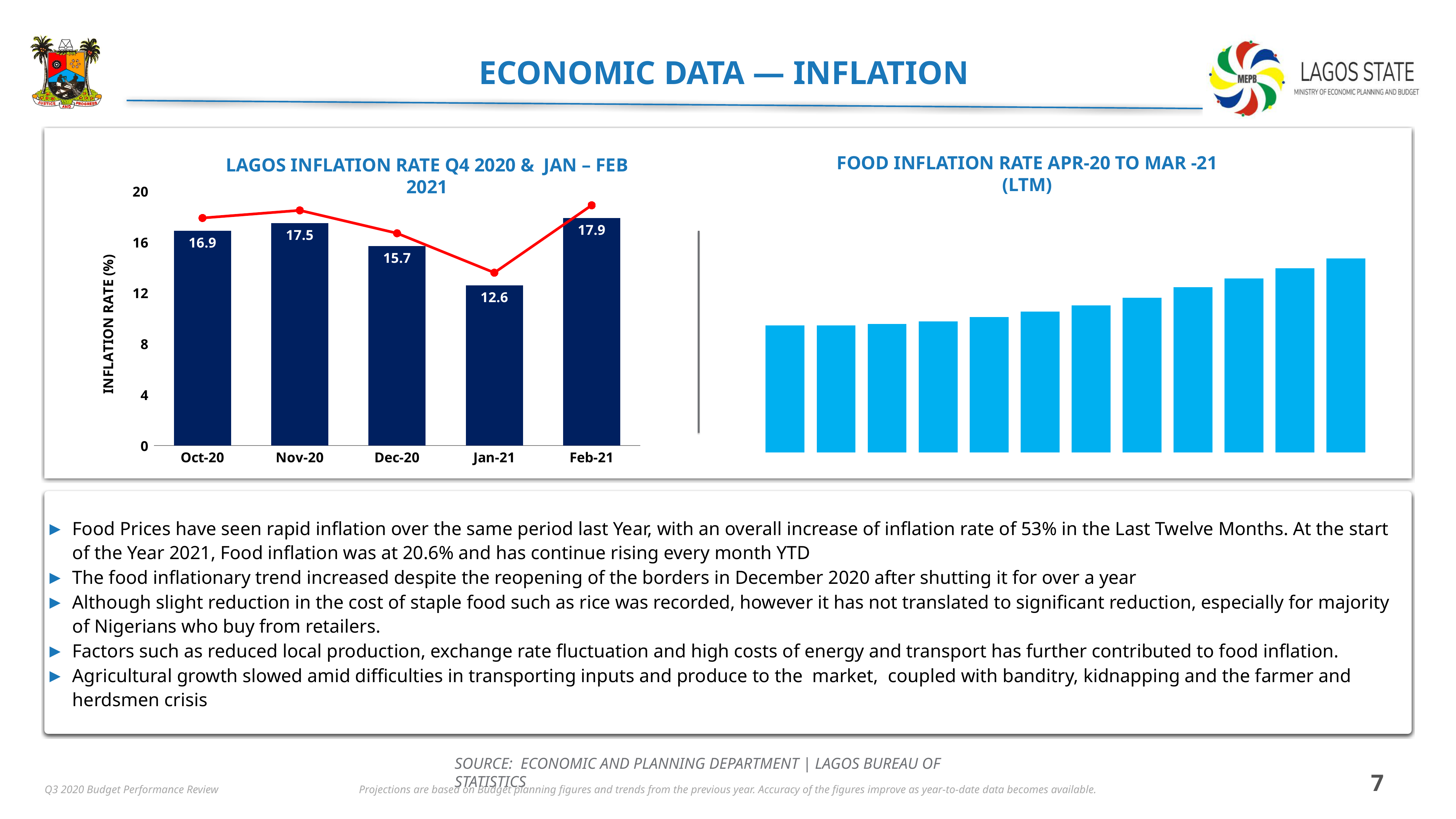
In the LAGOS INFLATION RATE chart, which month has the highest inflation rate? Feb-21 How many months are shown on the x axis of the LAGOS INFLATION RATE chart? 5 In the LAGOS INFLATION RATE chart, which is higher, the inflation rate for Nov-20 or Dec-20? Nov-20 In the LAGOS INFLATION RATE chart, what is the inflation rate for Oct-20? 16.9 In the LAGOS INFLATION RATE chart, which month has the lowest inflation rate? Jan-21 In the LAGOS INFLATION RATE chart, is the value for Jan-21 greater or less than 16? less What kind of chart is the FOOD INFLATION RATE APR-20 TO MAR -21 (LTM) chart? bar chart In the LAGOS INFLATION RATE chart, what is the difference between the Feb-21 and Jan-21 inflation rates? 5.3 In the FOOD INFLATION RATE APR-20 TO MAR -21 (LTM) chart, do the bars rise or fall from left to right? rise In the LAGOS INFLATION RATE chart, what is the inflation rate for Dec-20? 15.7 How many bars are plotted in the FOOD INFLATION RATE APR-20 TO MAR -21 (LTM) chart? 12 In the LAGOS INFLATION RATE chart, what is the inflation rate for Jan-21? 12.6